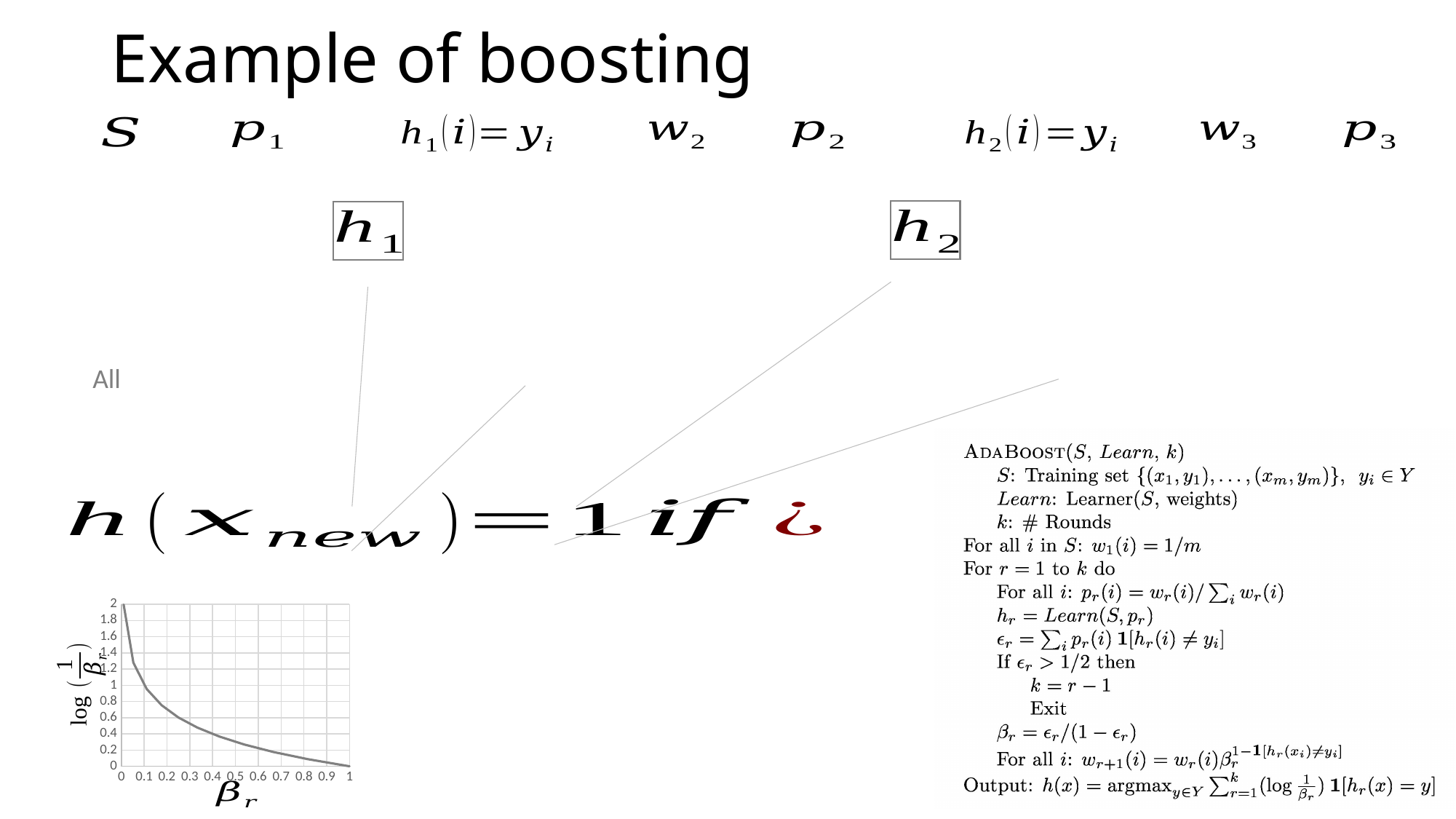
In the bottom-left chart, is the value at β_r = 0.5 greater or less than 0.6? less In the bottom-left chart, is the value at β_r = 0.2 greater or less than 0.4? greater In the bottom-left chart, is the value at β_r = 0.8 greater or less than 0.4? less In the bottom-left chart, what is the label on the y axis? log(1/β_r) In the bottom-left chart, what is the highest value shown on the y axis? 2 In the bottom-left chart, which is larger: the value at β_r = 0.3 or the value at β_r = 0.7? the value at β_r = 0.3 In the bottom-left chart, what is the label on the x axis? β_r In the bottom-left chart, how many tick labels are shown on the x axis? 11 In the bottom-left chart, what is the value of the curve at β_r = 1? 0 In the bottom-left chart, do the values rise or fall as β_r increases along the x axis? fall What kind of chart is shown at the bottom left of the slide? line chart